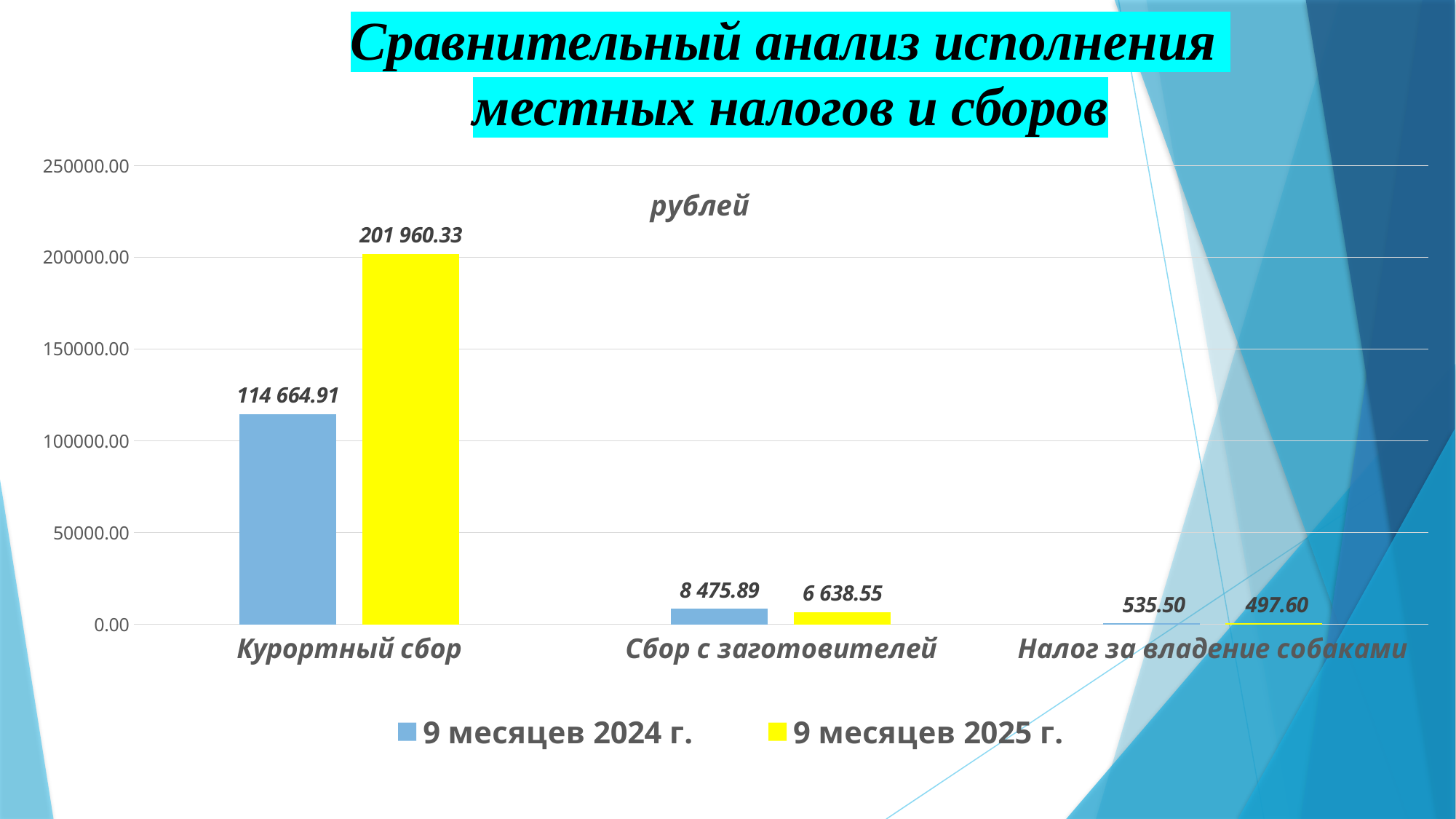
What is the value for Курортный сбор in the 9 месяцев 2025 г. series? 201 960.33 What is the value for Курортный сбор in the 9 месяцев 2024 г. series? 114 664.91 What is the difference between the 9 месяцев 2025 г. and 9 месяцев 2024 г. values for Курортный сбор? 87 295.42 Which category has the highest value in the 9 месяцев 2025 г. series? Курортный сбор How many series does the legend list? 2 What is the value for Сбор с заготовителей in the 9 месяцев 2024 г. series? 8 475.89 What kind of chart is shown on the slide? Bar chart What is the difference between the 9 месяцев 2024 г. and 9 месяцев 2025 г. values for Сбор с заготовителей? 1 837.34 How many categories are shown on the x axis? 3 For Сбор с заготовителей, which series has the larger value: 9 месяцев 2024 г. or 9 месяцев 2025 г.? 9 месяцев 2024 г. Which category has the lowest value in the 9 месяцев 2024 г. series? Налог за владение собаками What is the value for Налог за владение собаками in the 9 месяцев 2025 г. series? 497.60